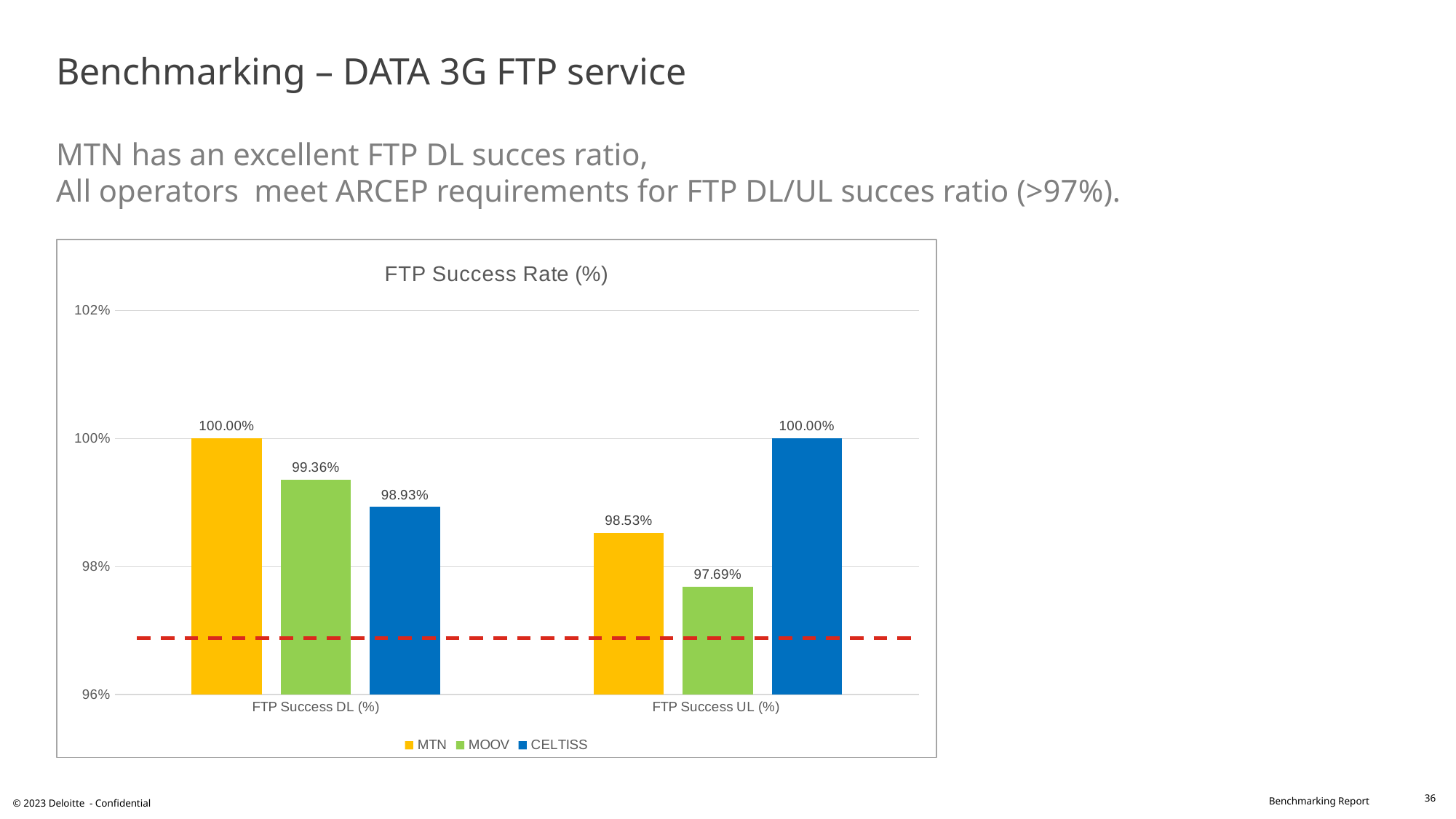
What is the FTP Success UL (%) value for MOOV? 97.69% Which operator has the lowest FTP Success UL (%)? MOOV What is the difference between MTN's and MOOV's FTP Success DL (%) values? 0.64% How many categories are shown on the x axis? 2 How many series does the legend list? 3 What is the FTP Success DL (%) value for MTN? 100.00% What kind of chart is shown on the slide? Bar chart Which operator has the highest FTP Success UL (%)? CELTISS Is the value for MOOV in FTP Success UL (%) greater or less than 98%? less What is the FTP Success DL (%) value for CELTISS? 98.93% What is the title of the chart? FTP Success Rate (%) Which is larger: MTN's FTP Success UL (%) or MOOV's FTP Success UL (%)? MTN